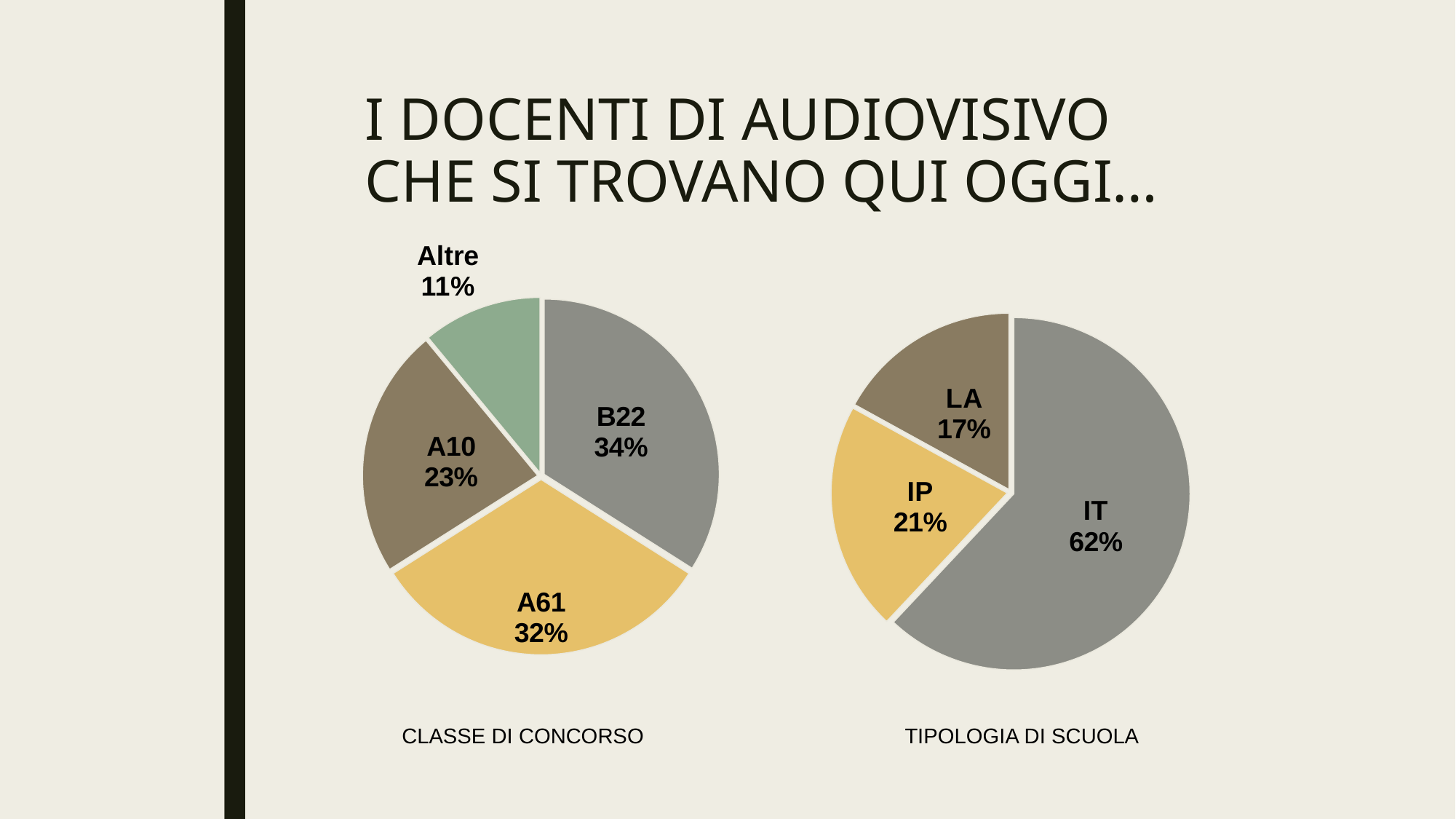
In the CLASSE DI CONCORSO chart, which is larger, A10 or A61? A61 In the CLASSE DI CONCORSO chart, which category has the smallest slice? Altre What type of chart is the TIPOLOGIA DI SCUOLA chart? Pie chart How many slices does the CLASSE DI CONCORSO chart have? 4 In the TIPOLOGIA DI SCUOLA chart, what is the difference in percentage points between IT and IP? 41 What is the title of the chart on the right side of the slide? TIPOLOGIA DI SCUOLA In the TIPOLOGIA DI SCUOLA chart, what share does IP have? 21% In the CLASSE DI CONCORSO chart, what share does B22 have? 34% In the CLASSE DI CONCORSO chart, what share does A10 have? 23% In the TIPOLOGIA DI SCUOLA chart, which category has the largest slice? IT In the CLASSE DI CONCORSO chart, what is the difference in percentage points between A61 and Altre? 21 In the TIPOLOGIA DI SCUOLA chart, which category has the smallest slice? LA